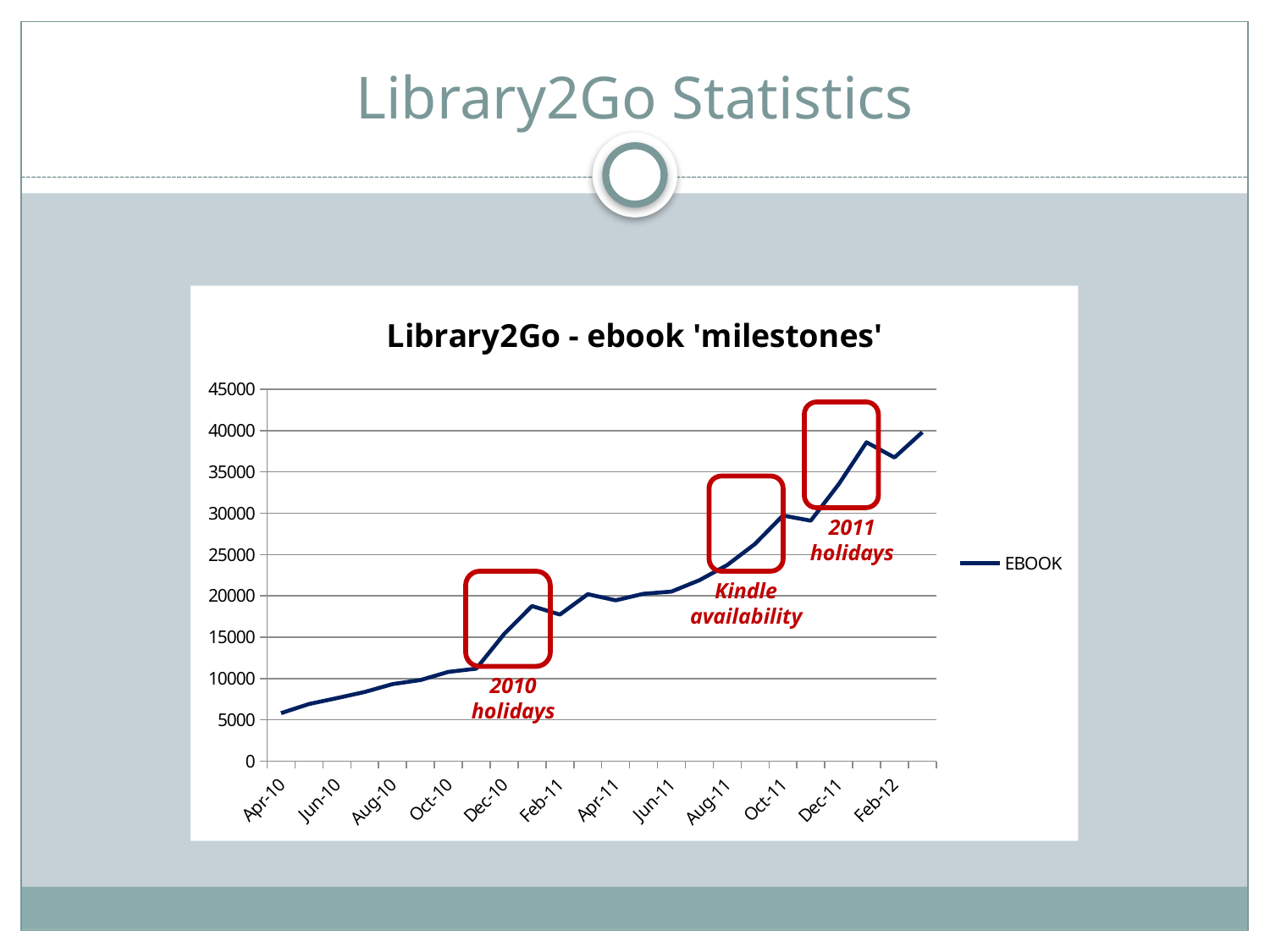
What is the name of the series shown in the legend? EBOOK Is the EBOOK value for Apr-10 greater or less than 10000? less Which has the larger EBOOK value, Apr-10 or Feb-12? Feb-12 Is the EBOOK value for Jun-11 greater or less than 15000? greater Do the EBOOK values generally rise or fall from Apr-10 to Feb-12? rise Is the EBOOK value for Feb-12 greater or less than 35000? greater How many series does the chart's legend list? 1 What is the title of the chart? Library2Go - ebook 'milestones' What kind of chart is shown on the slide? line chart Which has the larger EBOOK value, Jun-11 or Oct-11? Oct-11